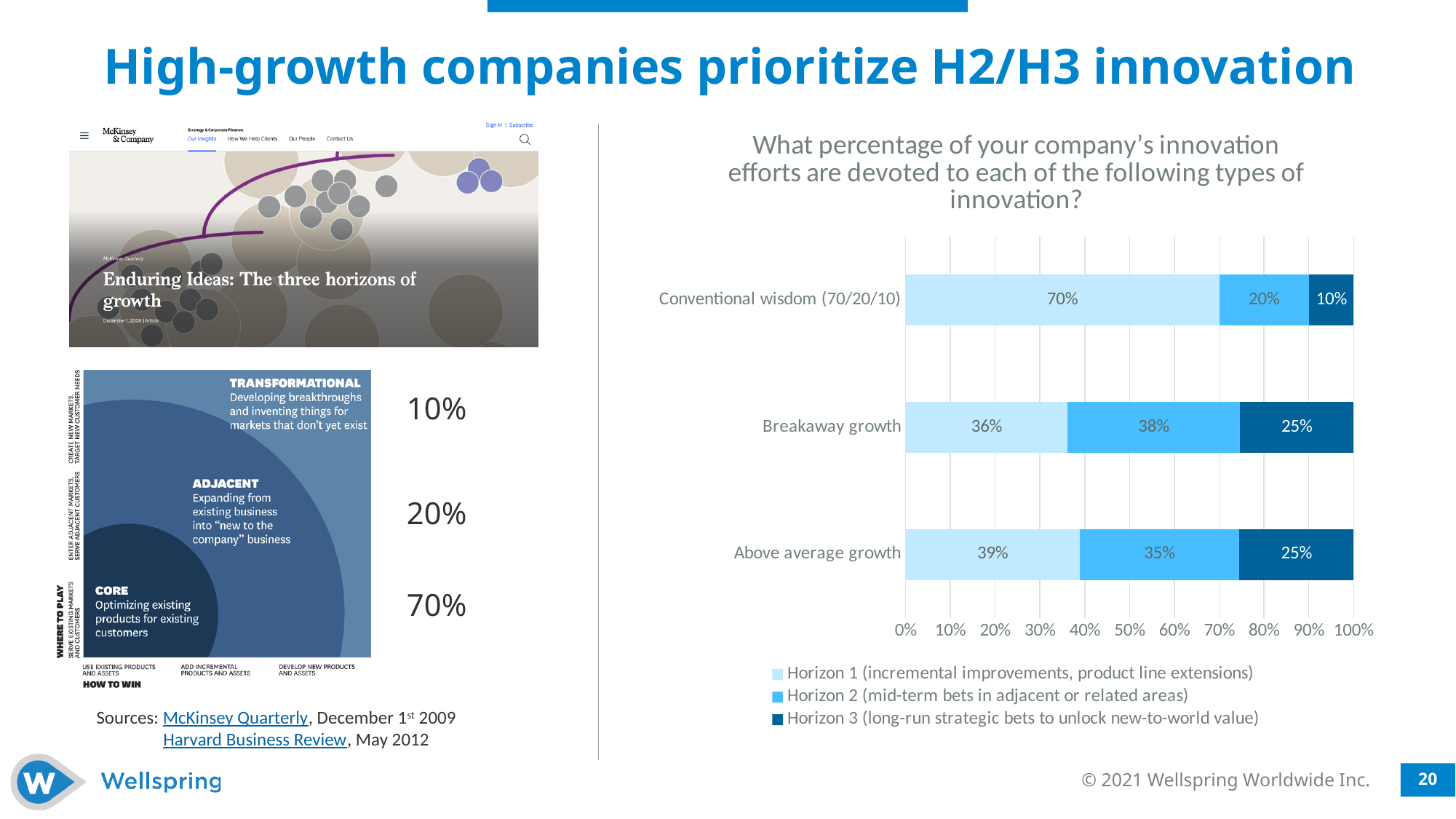
Which has the larger Horizon 2 value, Breakaway growth or Above average growth? Breakaway growth What is the Horizon 3 value for Conventional wisdom (70/20/10)? 10% What is the title of the chart? What percentage of your company's innovation efforts are devoted to each of the following types of innovation? What is the total of the stacked bar for Conventional wisdom (70/20/10)? 100% What kind of chart is shown on the right side of the slide? bar chart Which category has the lowest Horizon 3 value? Conventional wisdom (70/20/10) How many categories are plotted on the chart? 3 What is the Horizon 2 value for Breakaway growth? 38% How many series does the legend of the chart list? 3 What is the Horizon 1 value for Above average growth? 39% What is the difference between the Horizon 1 value for Conventional wisdom (70/20/10) and the Horizon 1 value for Breakaway growth? 34% Which category has the highest Horizon 1 value? Conventional wisdom (70/20/10)